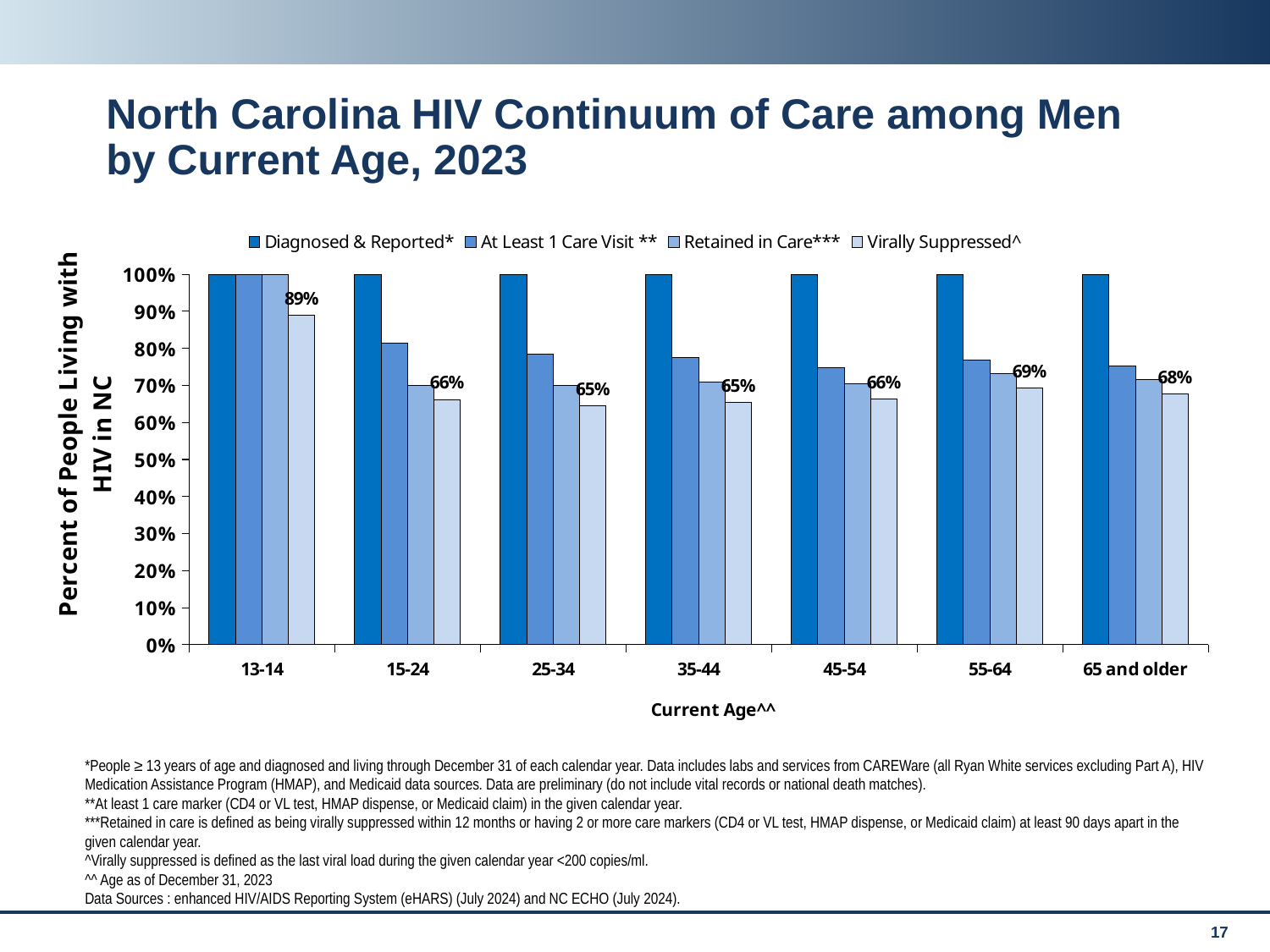
What is the Virally Suppressed^ value for the 65 and older age group? 68% What is the Virally Suppressed^ value for the 13-14 age group? 89% Which age group has the highest Virally Suppressed^ value? 13-14 What is the difference in Virally Suppressed^ values between the 13-14 and 15-24 age groups? 23 percentage points Which age group has a higher Virally Suppressed^ value, 13-14 or 45-54? 13-14 What is the Diagnosed & Reported* value for the 35-44 age group? 100% Is the At Least 1 Care Visit ** value for the 35-44 age group greater or less than 80%? less What kind of chart is shown on the slide? Bar chart How many age groups are shown on the x axis? 7 What is the Virally Suppressed^ value for the 55-64 age group? 69% Is the At Least 1 Care Visit ** value for the 45-54 age group greater or less than 70%? greater How many series does the legend list? 4